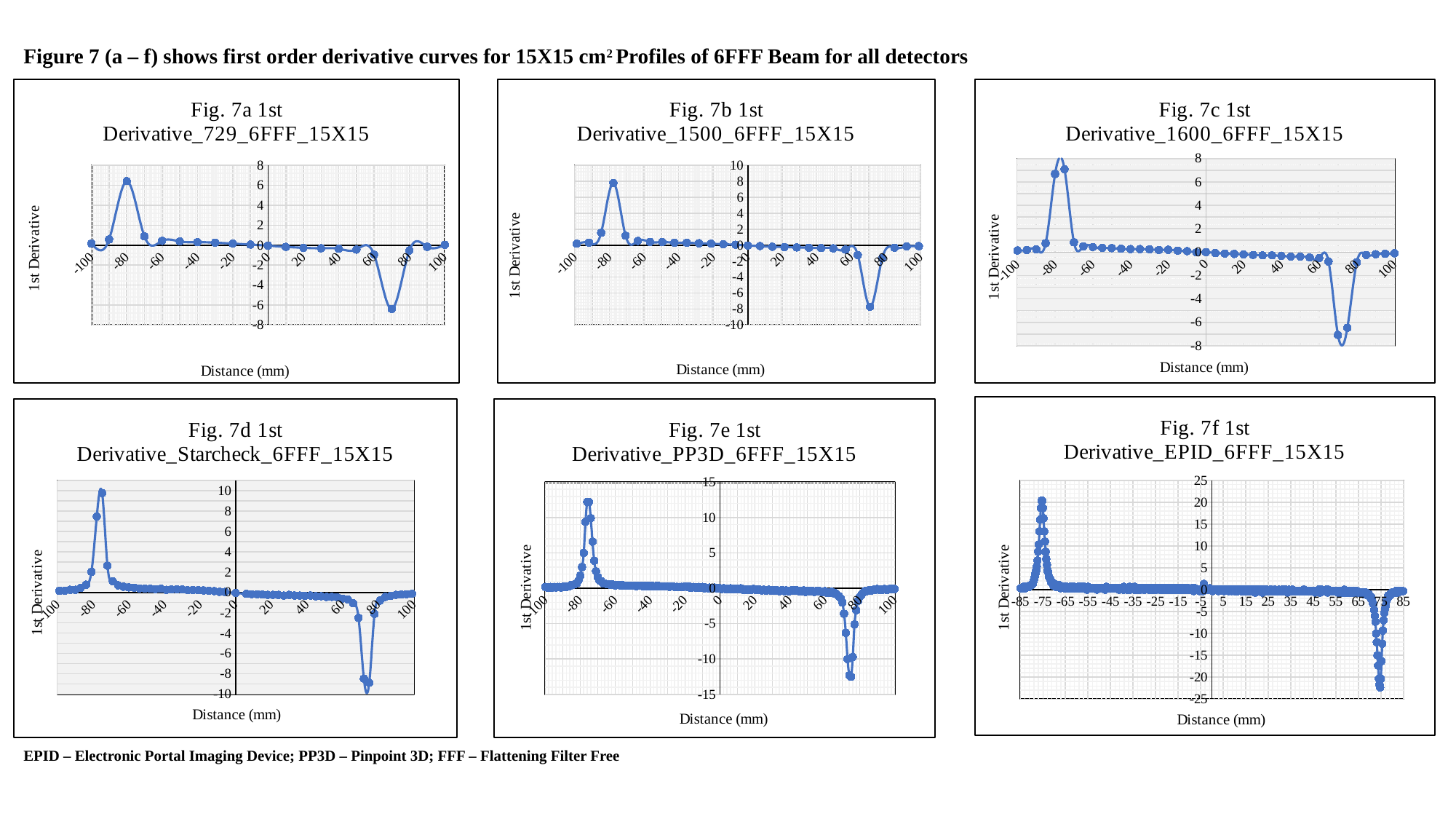
In Fig. 7f 1st Derivative_EPID_6FFF_15X15, is the peak value of the curve near -75 mm greater or less than 15? greater How many charts are shown on the slide? 6 In Fig. 7a 1st Derivative_729_6FFF_15X15, is the peak value of the curve near -80 mm greater or less than 4? greater In Fig. 7c 1st Derivative_1600_6FFF_15X15, is the value of the curve at 0 mm greater or less than 2? less What kind of chart is Fig. 7a 1st Derivative_729_6FFF_15X15? line chart In Fig. 7c 1st Derivative_1600_6FFF_15X15, what is the label on the vertical axis? 1st Derivative In Fig. 7a 1st Derivative_729_6FFF_15X15, does the curve rise or fall between -80 mm and -60 mm? fall